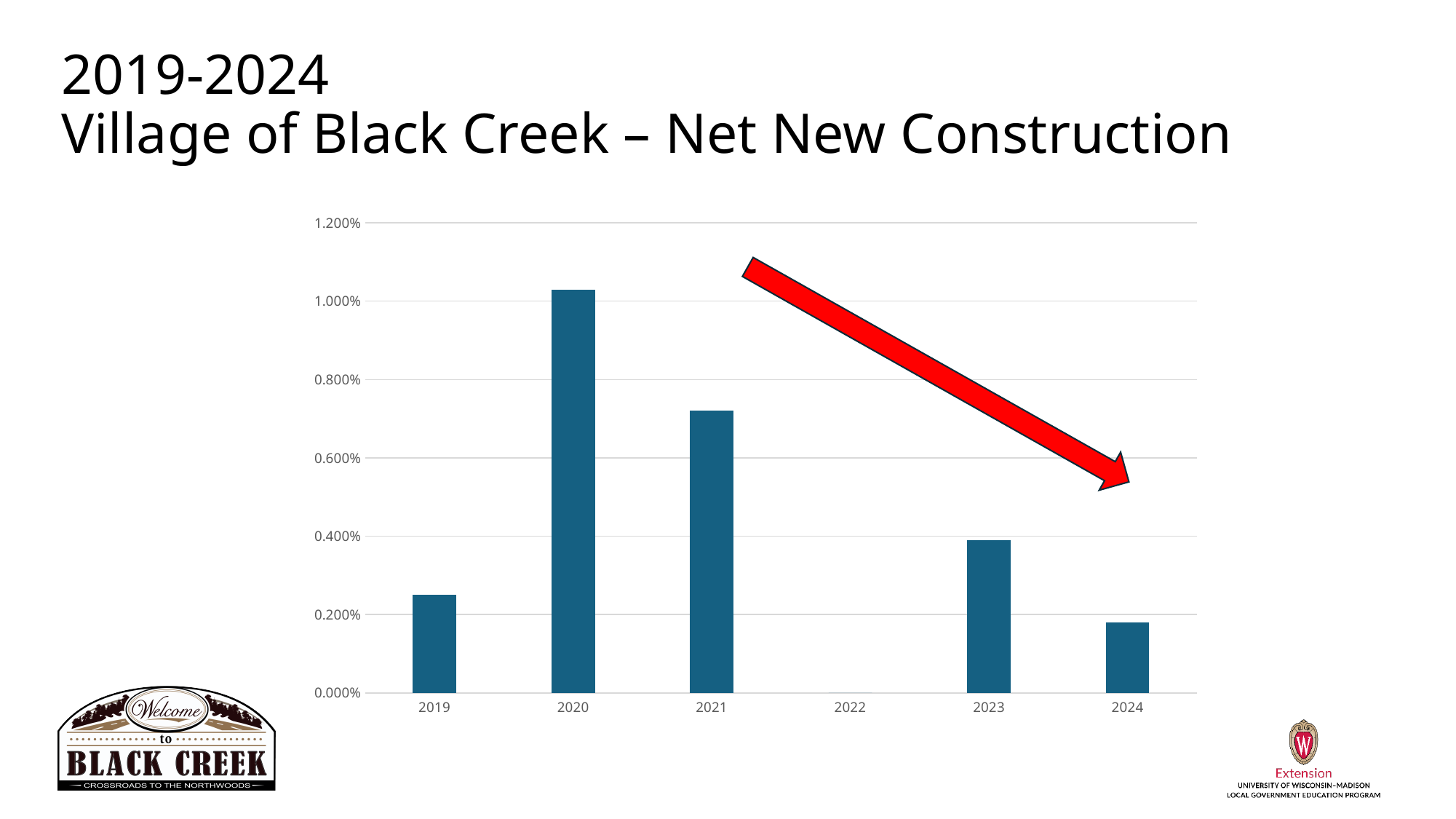
Is the value for 2021 greater or less than 0.600%? greater Is the value for 2019 greater or less than 0.200%? greater Is the value for 2024 greater or less than 0.400%? less Which year has the highest net new construction value? 2020 Which is larger, the value for 2019 or the value for 2024? 2019 What is the title of the slide containing the chart? 2019-2024 Village of Black Creek – Net New Construction What kind of chart is shown on the slide? bar chart Which year has no visible bar in the chart? 2022 Which is larger, the value for 2021 or the value for 2023? 2021 How many years are shown on the x axis of the chart? 6